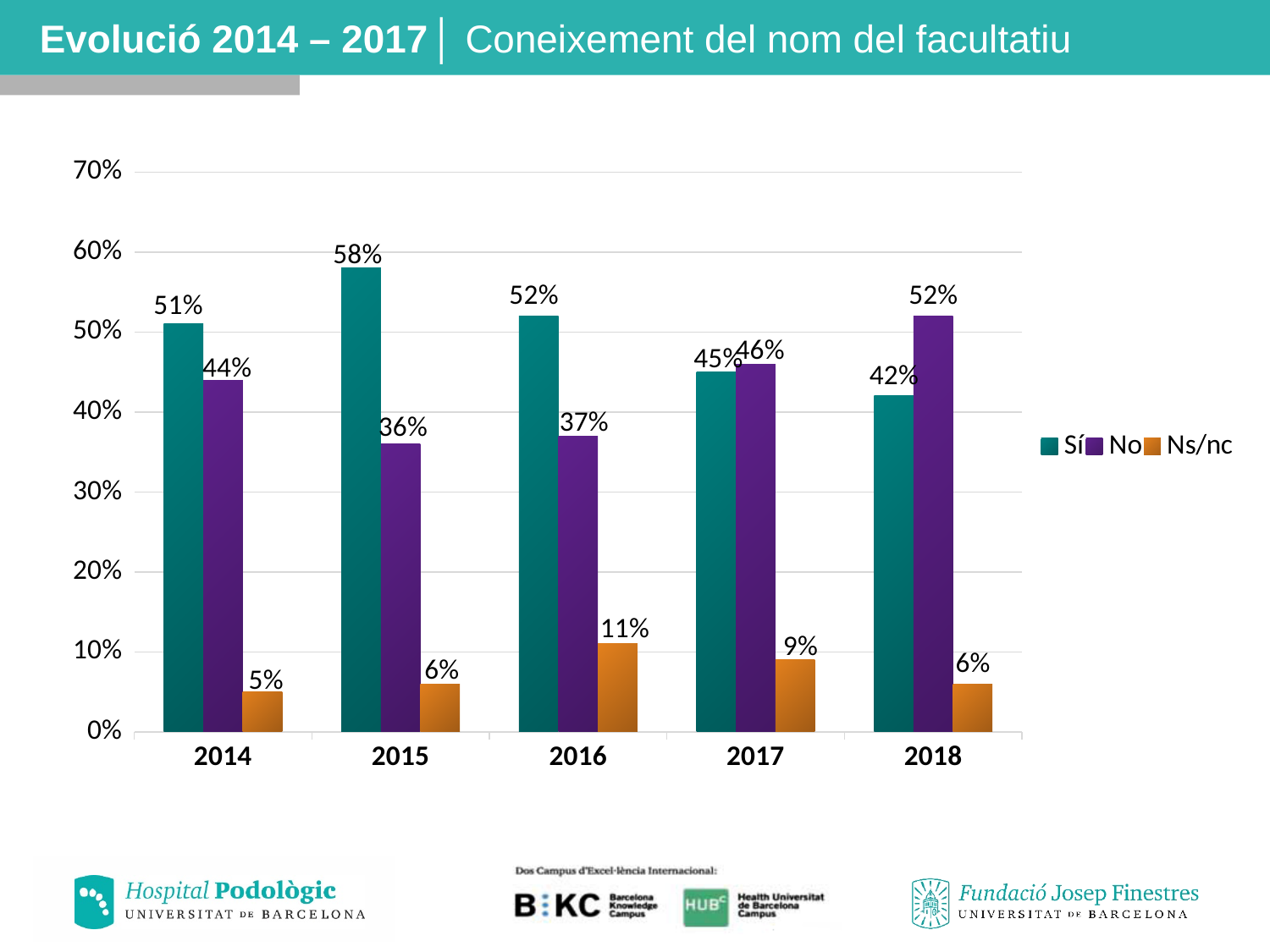
What is the difference between the Sí and No values in 2015? 22% How many series does the legend list? 3 What kind of chart is shown on the slide? bar chart In which year is the Sí value highest? 2015 Is the value for No in 2016 greater or less than 40%? less Which is larger in 2018, the Sí value or the No value? No What is the value for No in 2018? 52% In which year is the Ns/nc value lowest? 2014 How many years are shown on the x axis? 5 What is the value for Sí in 2015? 58% What is the value for Ns/nc in 2016? 11% Does the Sí value rise or fall from 2016 to 2018? fall